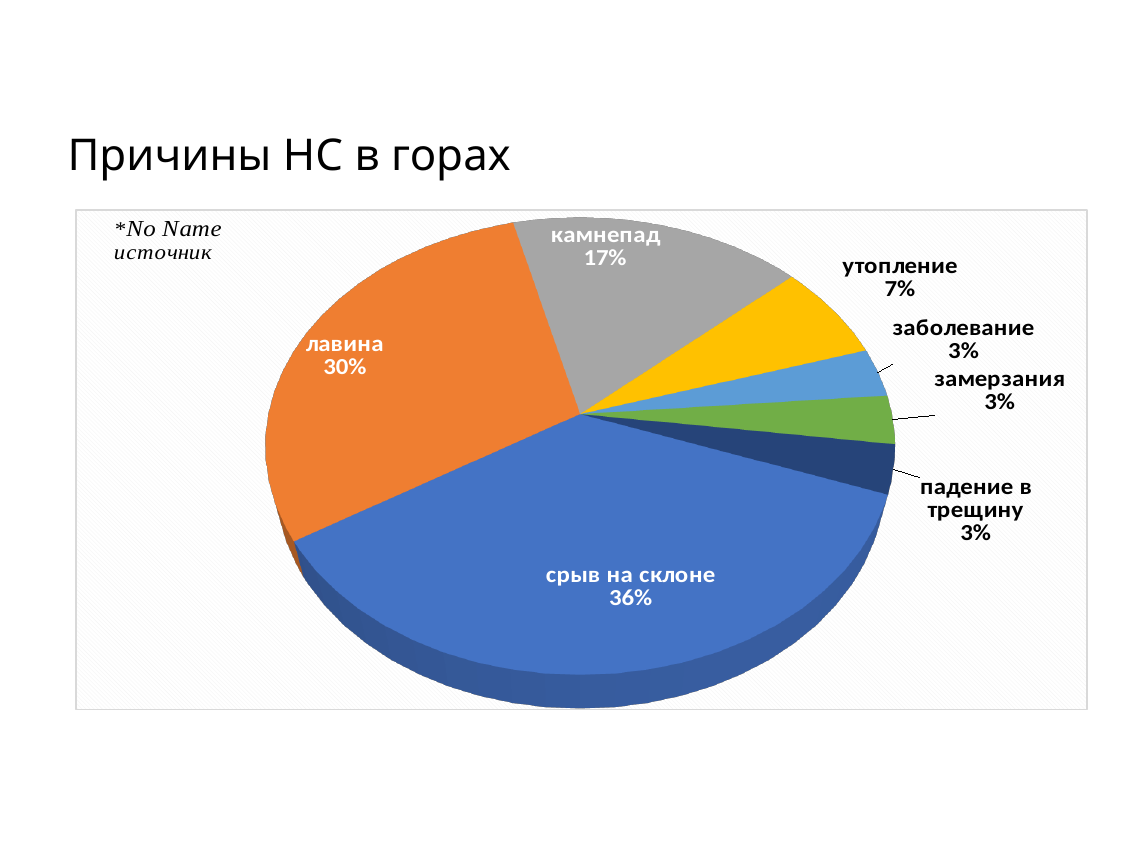
What is the difference between the shares of 'срыв на склоне' and 'лавина'? 6% Which category has the largest slice of the pie? срыв на склоне What kind of chart is shown on the slide? pie chart What is the difference between the shares of 'камнепад' and 'утопление'? 10% What share of the pie does 'срыв на склоне' have? 36% What is the value shown for 'заболевание'? 3% What share of the pie does 'лавина' have? 30% What is the value shown for 'камнепад'? 17% Which is larger, the share for 'камнепад' or the share for 'утопление'? камнепад What is the title of the slide containing the chart? Причины НС в горах How many slices does the pie chart have? 7 What is the value shown for 'утопление'? 7%